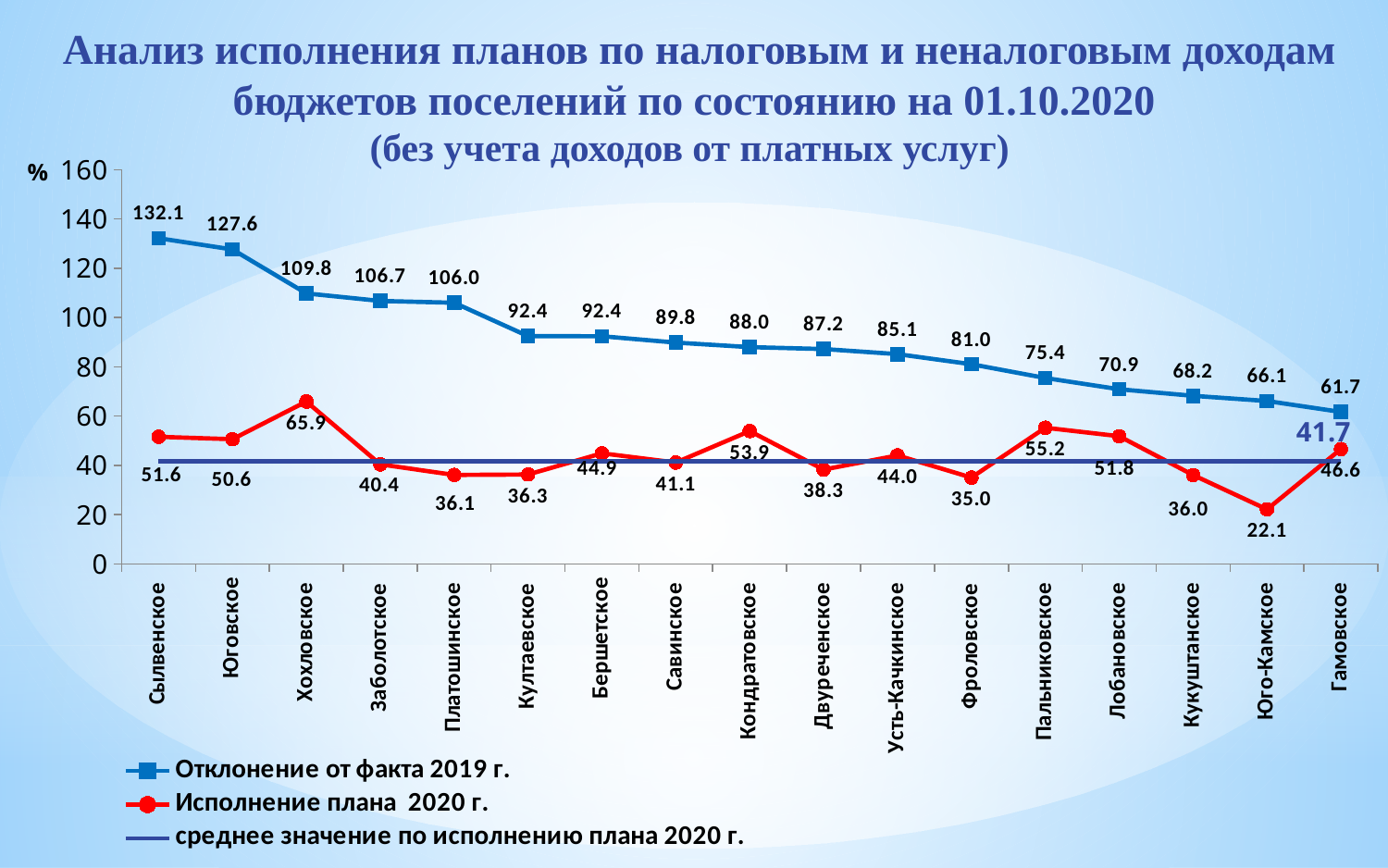
What is the value of "Исполнение плана 2020 г." for Хохловское? 65.9 What is the value of "Исполнение плана 2020 г." for Юго-Камское? 22.1 What is the average value for "Исполнение плана 2020 г." shown by the horizontal line? 41.7 What is the difference between the "Отклонение от факта 2019 г." values for Сылвенское and Гамовское? 70.4 What type of chart is shown on the slide? line chart Does the "Отклонение от факта 2019 г." series rise or fall from left to right along the x axis? fall What is the value of "Отклонение от факта 2019 г." for Сылвенское? 132.1 How many settlements are shown along the x axis? 17 Which settlement has the highest value for "Исполнение плана 2020 г."? Хохловское Which is larger for Пальниковское: "Отклонение от факта 2019 г." or "Исполнение плана 2020 г."? Отклонение от факта 2019 г. How many series does the legend list? 3 Which settlement has the lowest value for "Исполнение плана 2020 г."? Юго-Камское